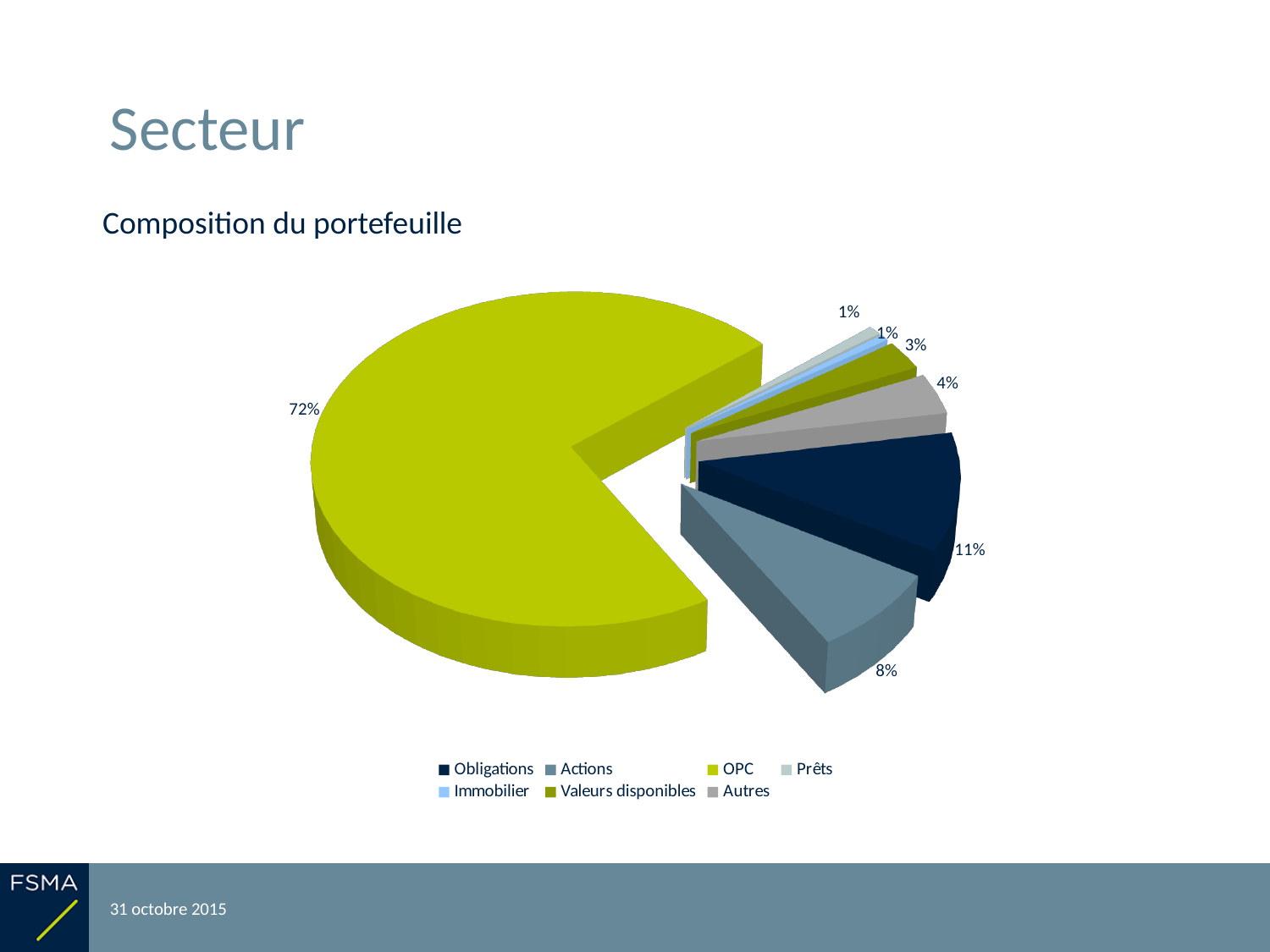
What percentage is shown for Immobilier? 1% Which category has the largest slice of the pie? OPC What kind of chart is shown on the slide? Pie chart What percentage is shown for Actions? 8% What is the title of the chart? Composition du portefeuille What is the difference in percentage points between the OPC share and the Obligations share? 61 percentage points What percentage is shown for Obligations? 11% How many categories does the legend list? 7 Which is larger, the share for Obligations or the share for Actions? Obligations What percentage is shown for Autres? 4% What percentage is shown for Valeurs disponibles? 3% What share of the portfolio does OPC represent in the pie chart? 72%